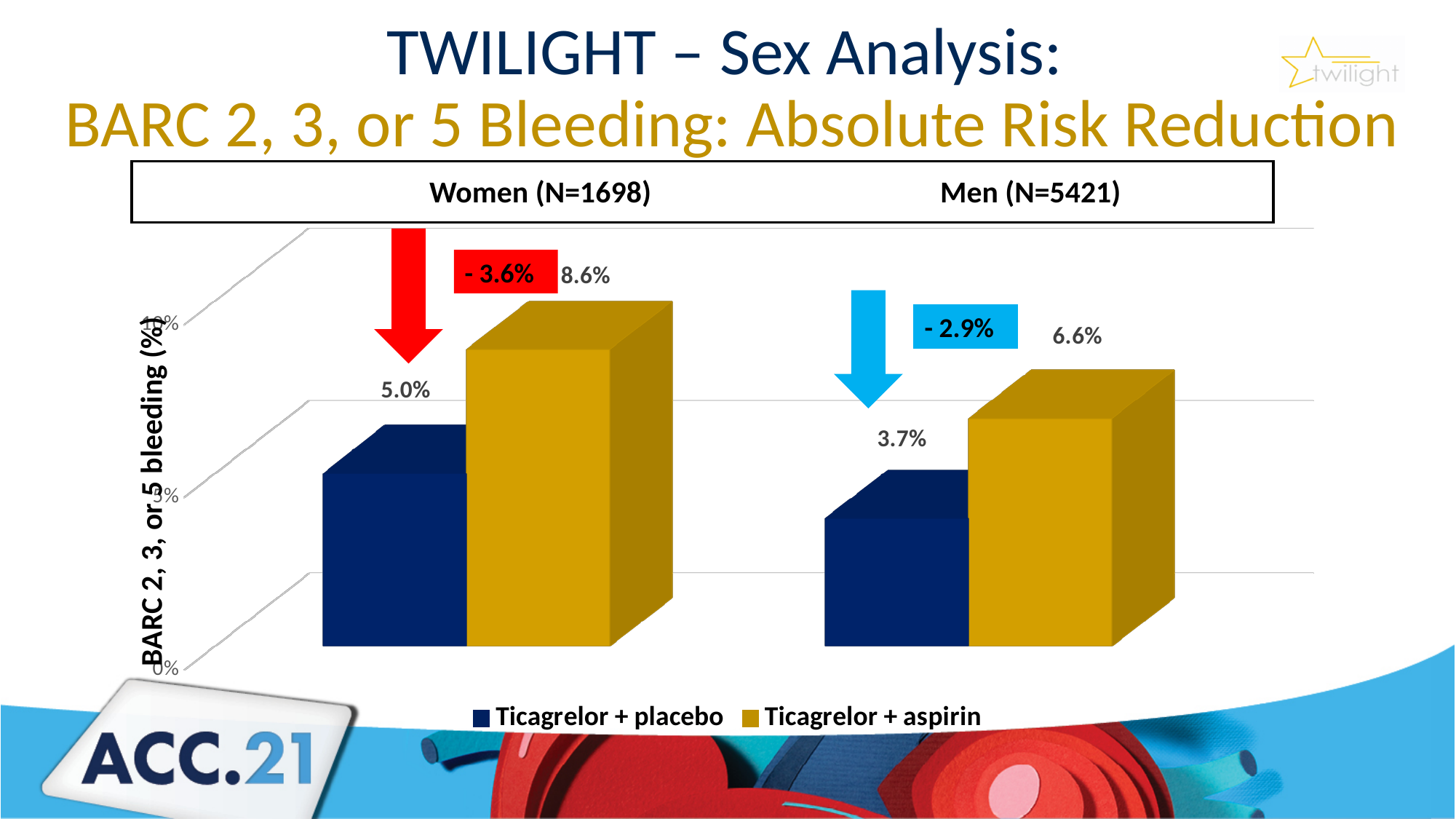
Which group and treatment has the lowest bleeding rate on the chart? Men, Ticagrelor + placebo What absolute risk reduction is shown for women? - 3.6% How many series does the legend list? 2 What is the BARC 2, 3, or 5 bleeding rate for Ticagrelor + placebo among women? 5.0% What is the BARC 2, 3, or 5 bleeding rate for Ticagrelor + aspirin among men? 6.6% What kind of chart is shown on the slide? Bar chart What is the BARC 2, 3, or 5 bleeding rate for Ticagrelor + placebo among men? 3.7% What is the BARC 2, 3, or 5 bleeding rate for Ticagrelor + aspirin among women? 8.6% What is the difference between the Ticagrelor + aspirin bleeding rates for women and men? 2.0% Which group and treatment has the highest bleeding rate on the chart? Women, Ticagrelor + aspirin What absolute risk reduction is shown for men? - 2.9% Which is larger: the Ticagrelor + placebo rate for women or the Ticagrelor + aspirin rate for men? Ticagrelor + aspirin rate for men